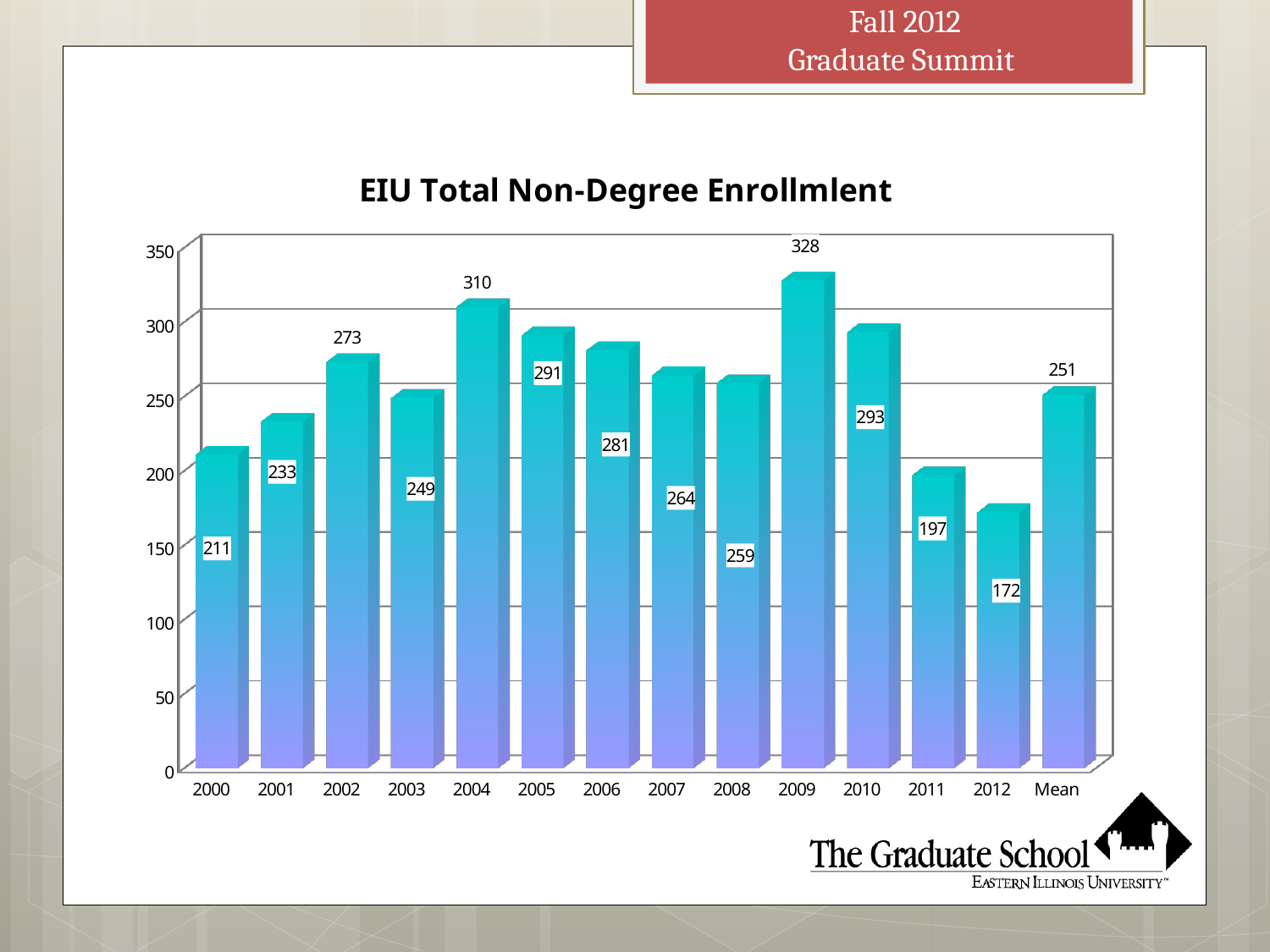
How many bars are shown in the chart, including the Mean bar? 14 Which year has the lowest non-degree enrollment? 2012 What is the difference between the 2009 and 2012 enrollment values? 156 What is the EIU total non-degree enrollment for 2004? 310 Do the enrollment values rise or fall from 2009 to 2012? Fall What is the value shown for the Mean bar? 251 Which is larger, the enrollment for 2005 or for 2010? 2010 Is the value for 2011 greater or less than 200? less What kind of chart is shown on the slide? Bar chart Which year has the highest non-degree enrollment? 2009 What is the title of the chart? EIU Total Non-Degree Enrollmlent What is the enrollment value for 2012? 172